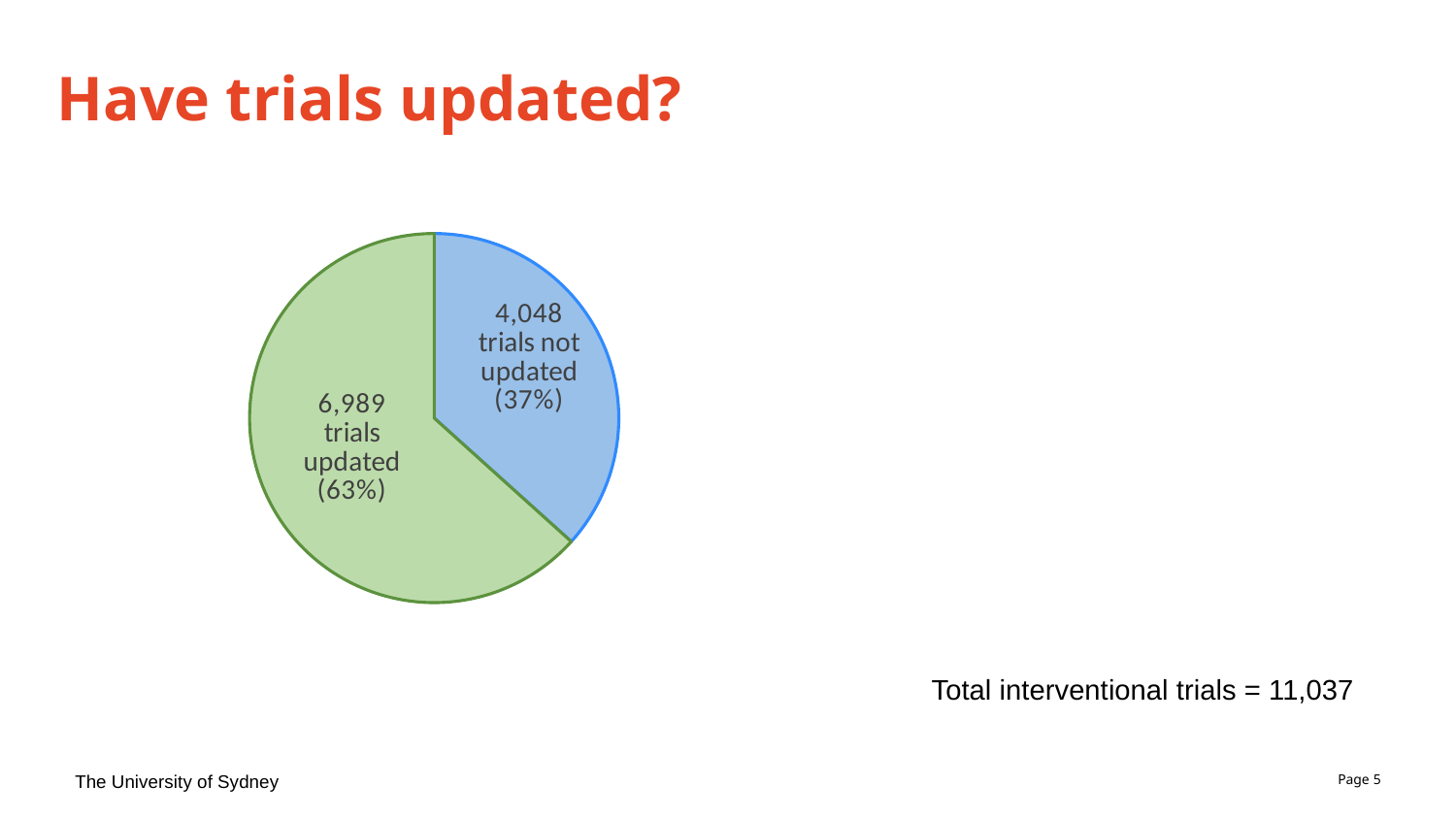
What share of the pie do the trials not updated represent? 37% Which category has the smallest slice in the pie chart? trials not updated How many trials were updated according to the pie chart? 6,989 What kind of chart is shown on the slide? pie chart What share of the pie do the trials updated represent? 63% What is the total number of interventional trials stated on the slide? 11,037 What is the difference between the number of trials updated and the number of trials not updated? 2,941 What colour is the slice for trials not updated? blue Which slice of the pie chart is larger: trials updated or trials not updated? trials updated How many trials were not updated according to the pie chart? 4,048 What is the title of the slide containing the pie chart? Have trials updated? How many slices does the pie chart have? 2